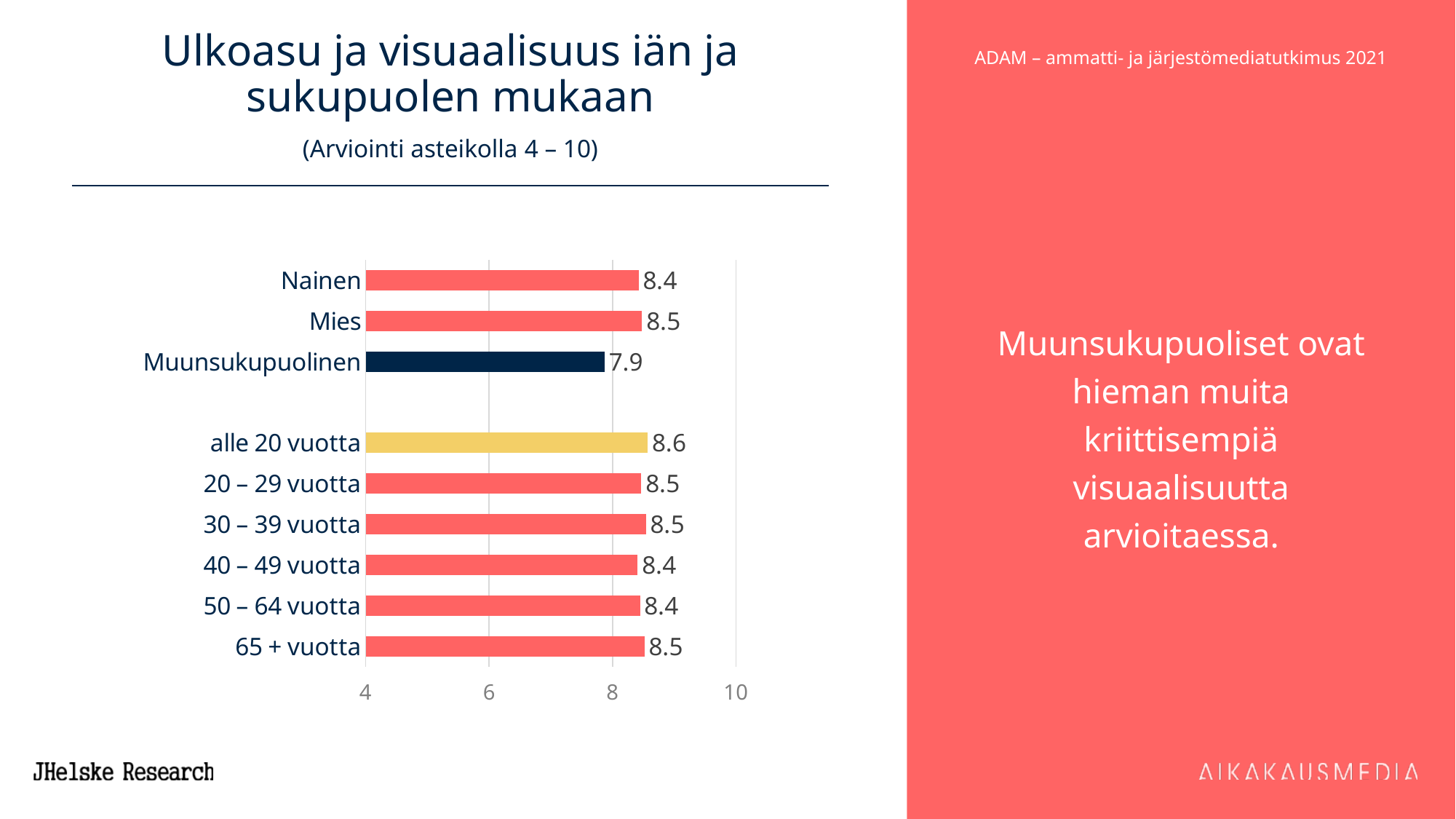
How many categories are shown in the chart? 9 What kind of chart is shown on the slide? bar chart What is the difference between the values for alle 20 vuotta and 40 – 49 vuotta? 0.2 What is the value for 65 + vuotta? 8.5 What is the value for Muunsukupuolinen? 7.9 What is the value for Nainen? 8.4 Is the value for Muunsukupuolinen greater or less than 8? less What is the value for alle 20 vuotta? 8.6 Which is larger, the value for Mies or the value for Muunsukupuolinen? Mies Which category has the lowest value? Muunsukupuolinen What is the difference between the values for Mies and Muunsukupuolinen? 0.6 Which category has the highest value? alle 20 vuotta